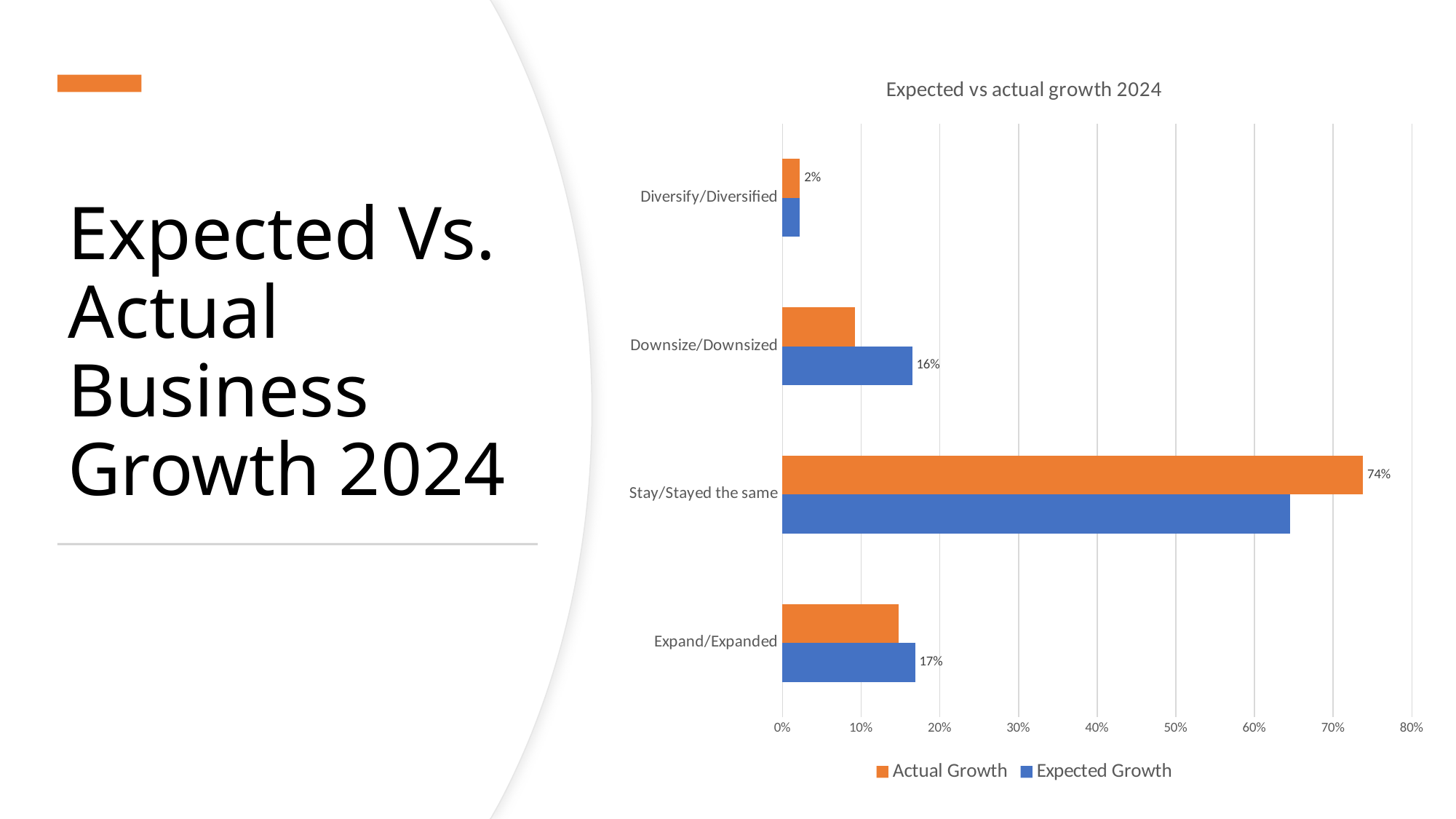
For Stay/Stayed the same, which is larger: Actual Growth or Expected Growth? Actual Growth Is the Expected Growth value for Stay/Stayed the same greater or less than 60%? greater What type of chart is shown on the slide? Bar chart How many categories are shown on the chart? 4 Which category has the lowest Actual Growth value? Diversify/Diversified Which category has the highest Actual Growth value? Stay/Stayed the same What is the Expected Growth value for Expand/Expanded? 17% How many series does the legend list? 2 What is the Actual Growth value for Diversify/Diversified? 2% What is the Actual Growth value for Stay/Stayed the same? 74% What is the Expected Growth value for Downsize/Downsized? 16%